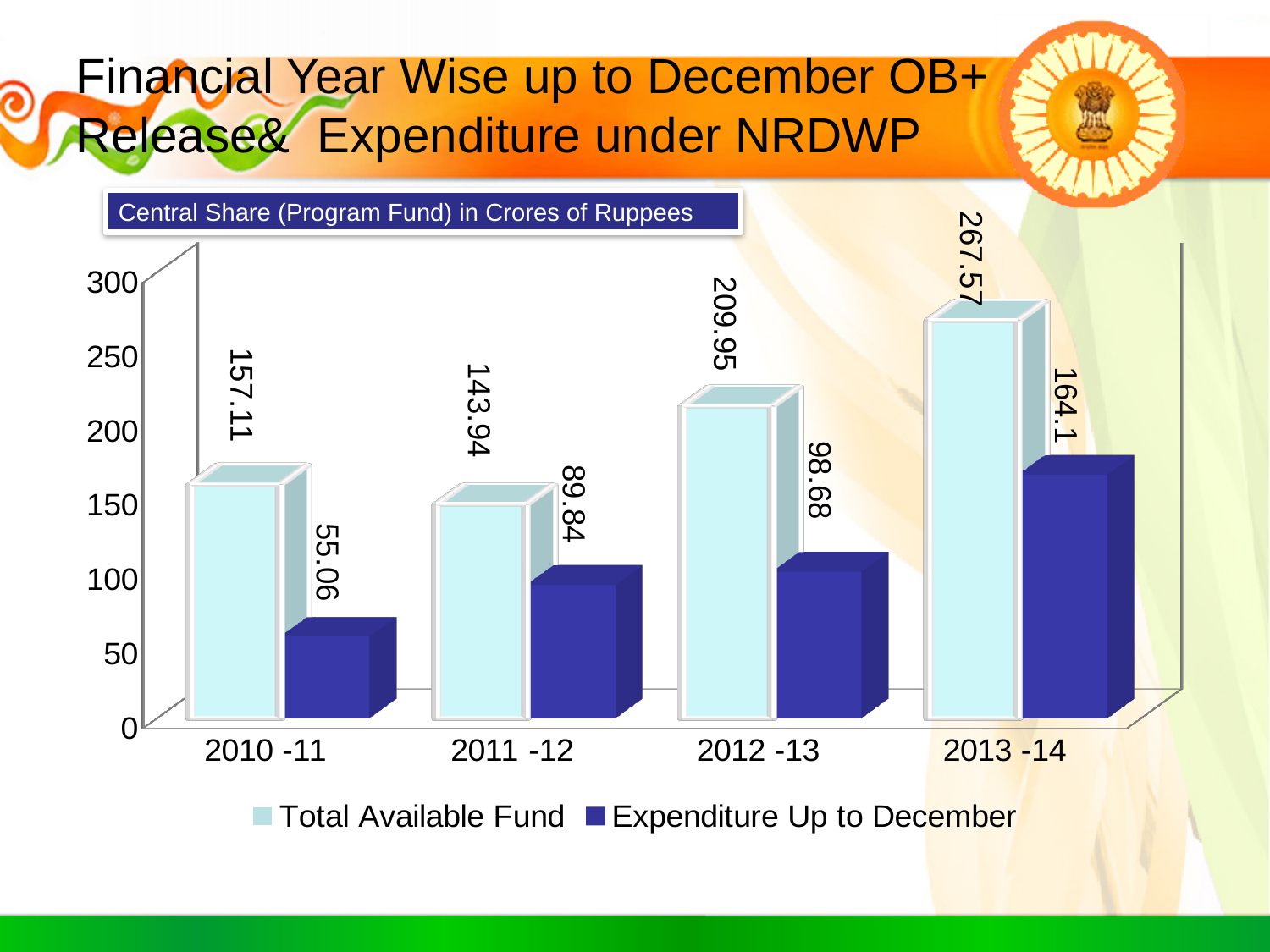
Which year has the lowest Expenditure Up to December? 2010 -11 How many series does the legend list? 2 What is the difference between Total Available Fund and Expenditure Up to December in 2012 -13? 111.27 Which is larger: the Total Available Fund for 2010 -11 or for 2011 -12? 2010 -11 How many financial years are shown on the x axis? 4 Which year has the highest Total Available Fund? 2013 -14 What kind of chart is shown on the slide? bar chart Does the Expenditure Up to December rise or fall from 2010 -11 to 2013 -14? rise What is the Expenditure Up to December for 2013 -14? 164.1 What is the Expenditure Up to December for 2011 -12? 89.84 What is the Total Available Fund for 2010 -11? 157.11 What unit is stated in the box above the chart? Crores of Ruppees